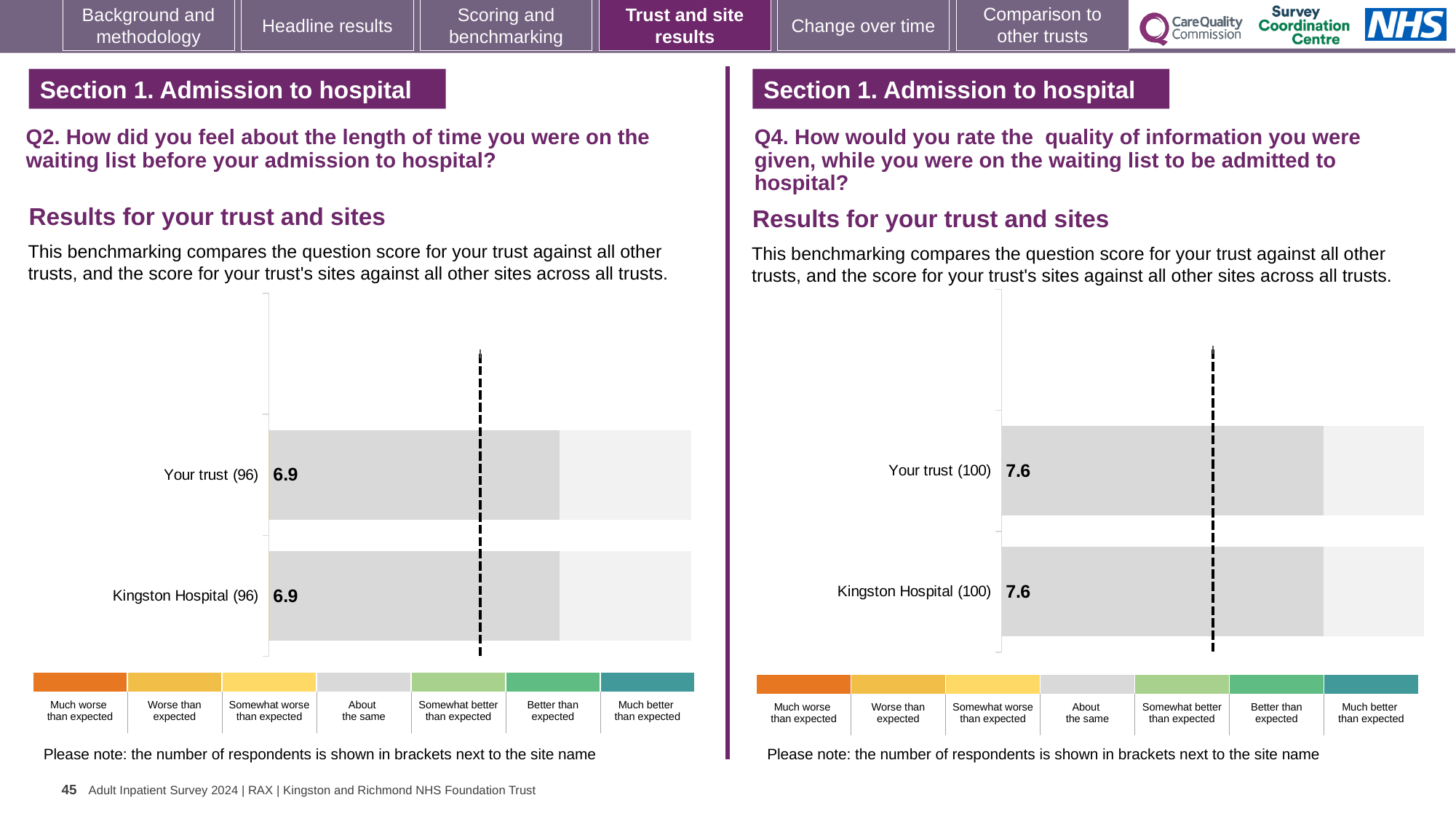
In the left chart (Q2), what is the score for Your trust? 6.9 In the right chart (Q4), what is the difference between the score for Your trust and the score for Kingston Hospital? 0 In the right chart (Q4), what is the score for Kingston Hospital? 7.6 In the right chart (Q4), what is the score for Your trust? 7.6 In the left chart (Q2), what is the difference between the score for Your trust and the score for Kingston Hospital? 0 How many bars are plotted in the right chart (Q4)? 2 In the left chart (Q2), what is the score for Kingston Hospital? 6.9 What kind of chart is used for the Q4 results on the right? Bar chart In the left chart (Q2), how many respondents are shown in brackets next to Kingston Hospital? 96 In the right chart (Q4), how many respondents are shown in brackets next to Your trust? 100 What kind of chart is used for the Q2 results on the left? Bar chart How many bars are plotted in the left chart (Q2)? 2